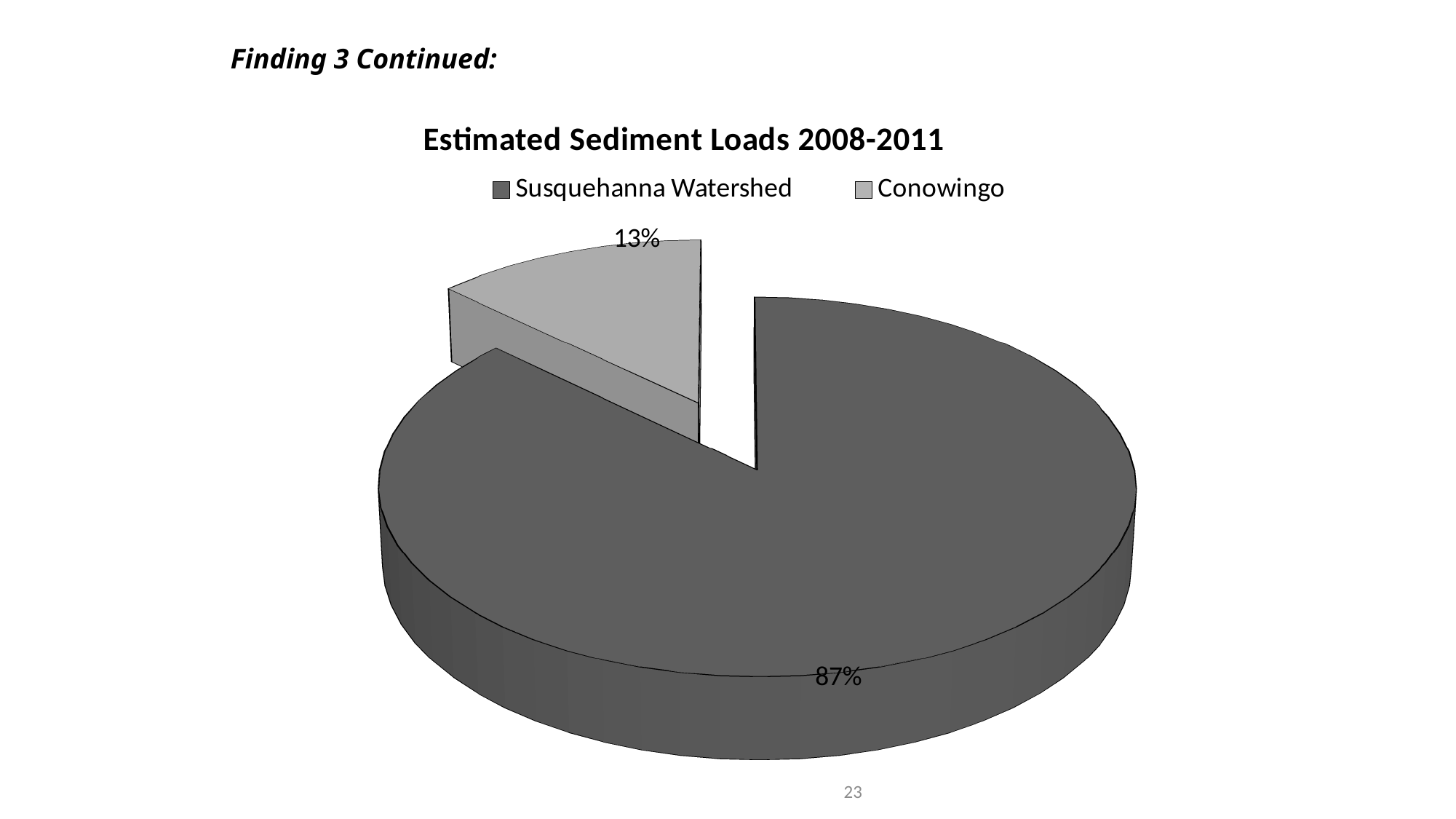
What share of the pie does Conowingo account for? 13% What is the title of the chart? Estimated Sediment Loads 2008-2011 Which is larger, the Susquehanna Watershed slice or the Conowingo slice? Susquehanna Watershed How many entries does the legend list? 2 What share of the pie does Susquehanna Watershed account for? 87% Which category is shown in the lighter grey colour? Conowingo Which category has the largest slice of the pie? Susquehanna Watershed Which category has the smallest slice of the pie? Conowingo What is the difference in percentage points between the Susquehanna Watershed slice and the Conowingo slice? 74 What kind of chart is shown on the slide? Pie chart How many categories does the pie chart show? 2